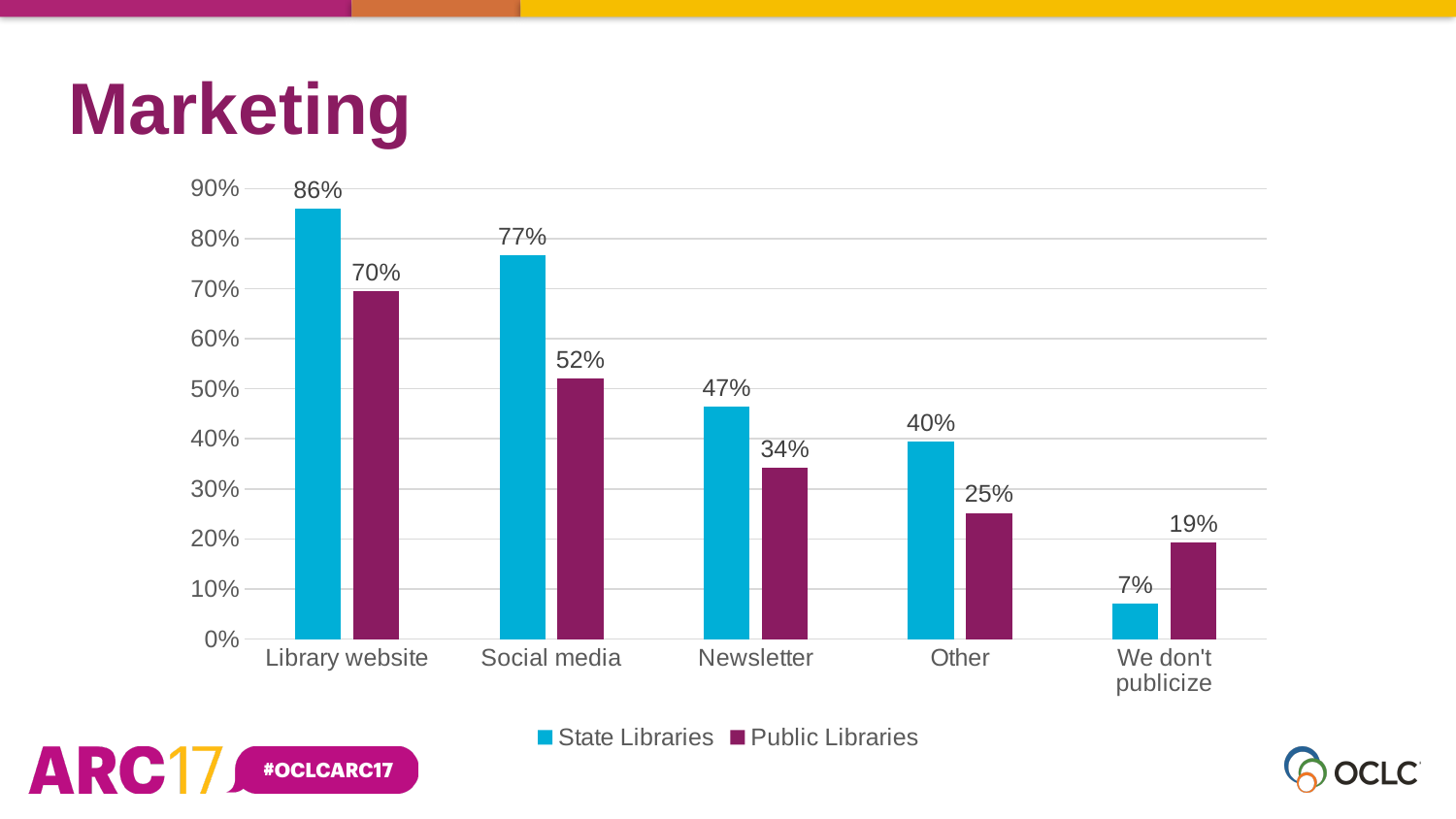
What is the title of the slide? Marketing Is the value for State Libraries for Social media greater or less than 70%? greater What kind of chart is shown on the slide? bar chart Which category has the highest value for State Libraries? Library website What is the value for State Libraries for Library website? 86% How many categories are shown on the x axis? 5 What is the value for Public Libraries for We don't publicize? 19% Which category has the lowest value for Public Libraries? We don't publicize What is the difference between State Libraries and Public Libraries for Newsletter? 13% Which is larger for Other: State Libraries or Public Libraries? State Libraries What is the value for Public Libraries for Social media? 52% How many series does the legend list? 2